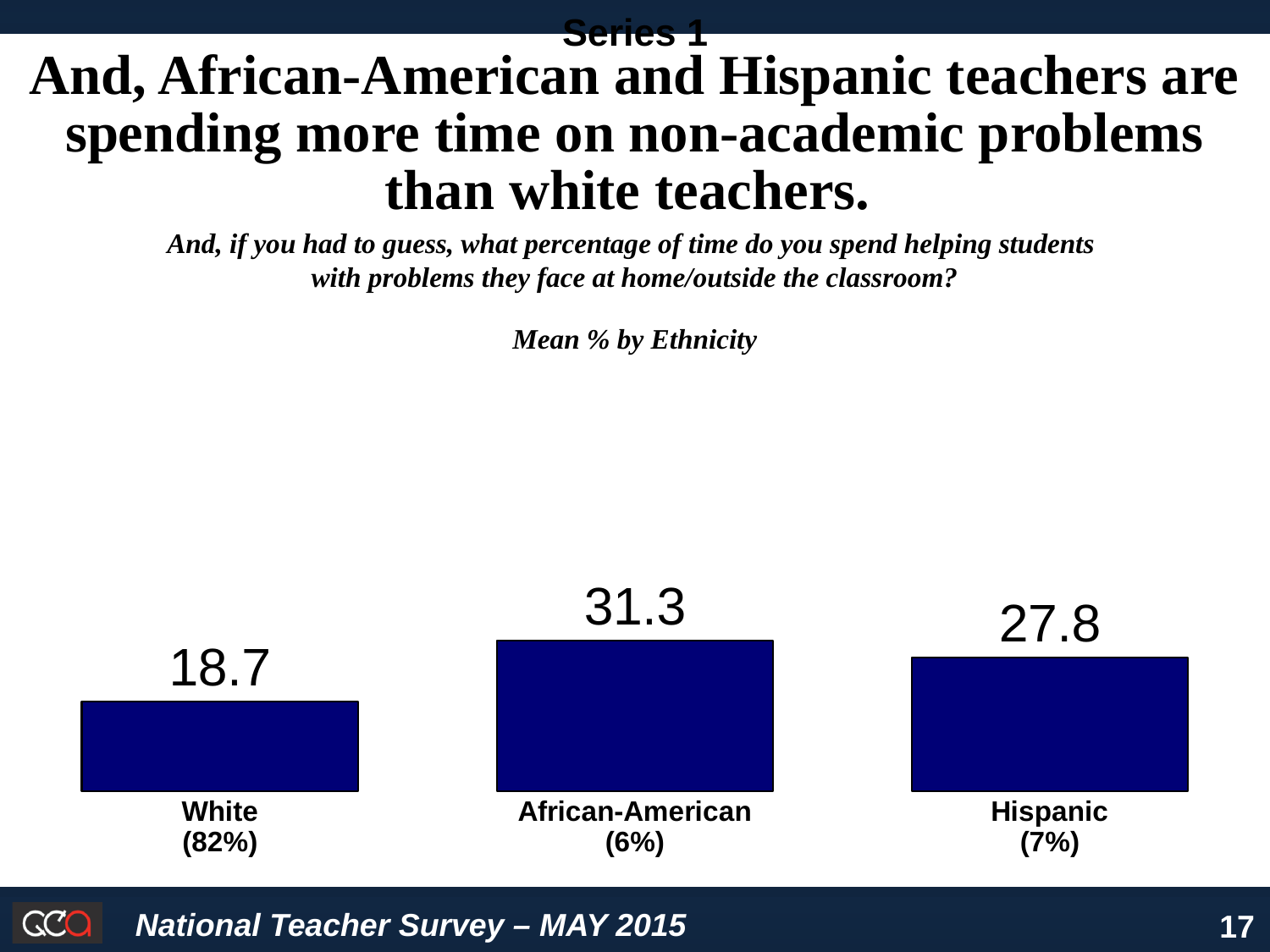
What is the difference between the values for African-American and Hispanic teachers? 3.5 What is the value for White teachers? 18.7 What is the value for Hispanic teachers? 27.8 What percentage of the sample is shown in parentheses under the White category label? 82% Which ethnicity group has the highest value? African-American Which is larger, the value for Hispanic teachers or the value for White teachers? Hispanic How many ethnicity categories are shown in the chart? 3 What is the difference between the values for African-American and White teachers? 12.6 What kind of chart is shown on the slide? Bar chart What is the value for African-American teachers? 31.3 Which ethnicity group has the lowest value? White What is the chart's title text shown above the slide heading? Series 1